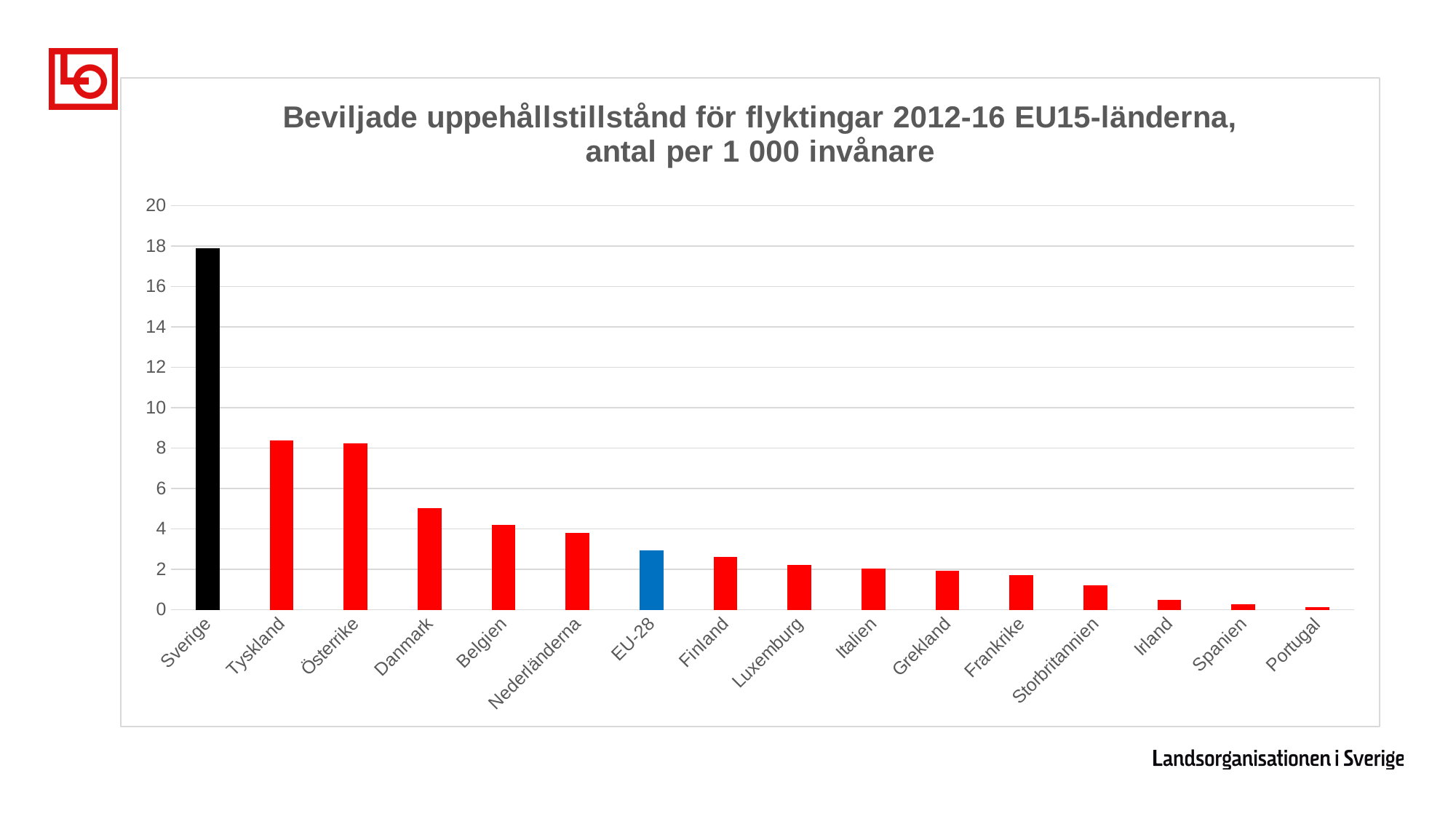
Which country has the highest value? Sverige Is the value for Tyskland greater or less than 6? greater Which is larger, the value for Danmark or the value for Belgien? Danmark Which is larger, the value for Nederländerna or the value for EU-28? Nederländerna What colour is the bar for EU-28? Blue Which country has the lowest value? Portugal Is the value for Frankrike greater or less than 2? less How many categories (bars) are shown on the x axis? 16 Is the value for Sverige greater or less than 16? greater What kind of chart is shown on the slide? Bar chart Do the values rise or fall moving from left to right along the x axis? Fall